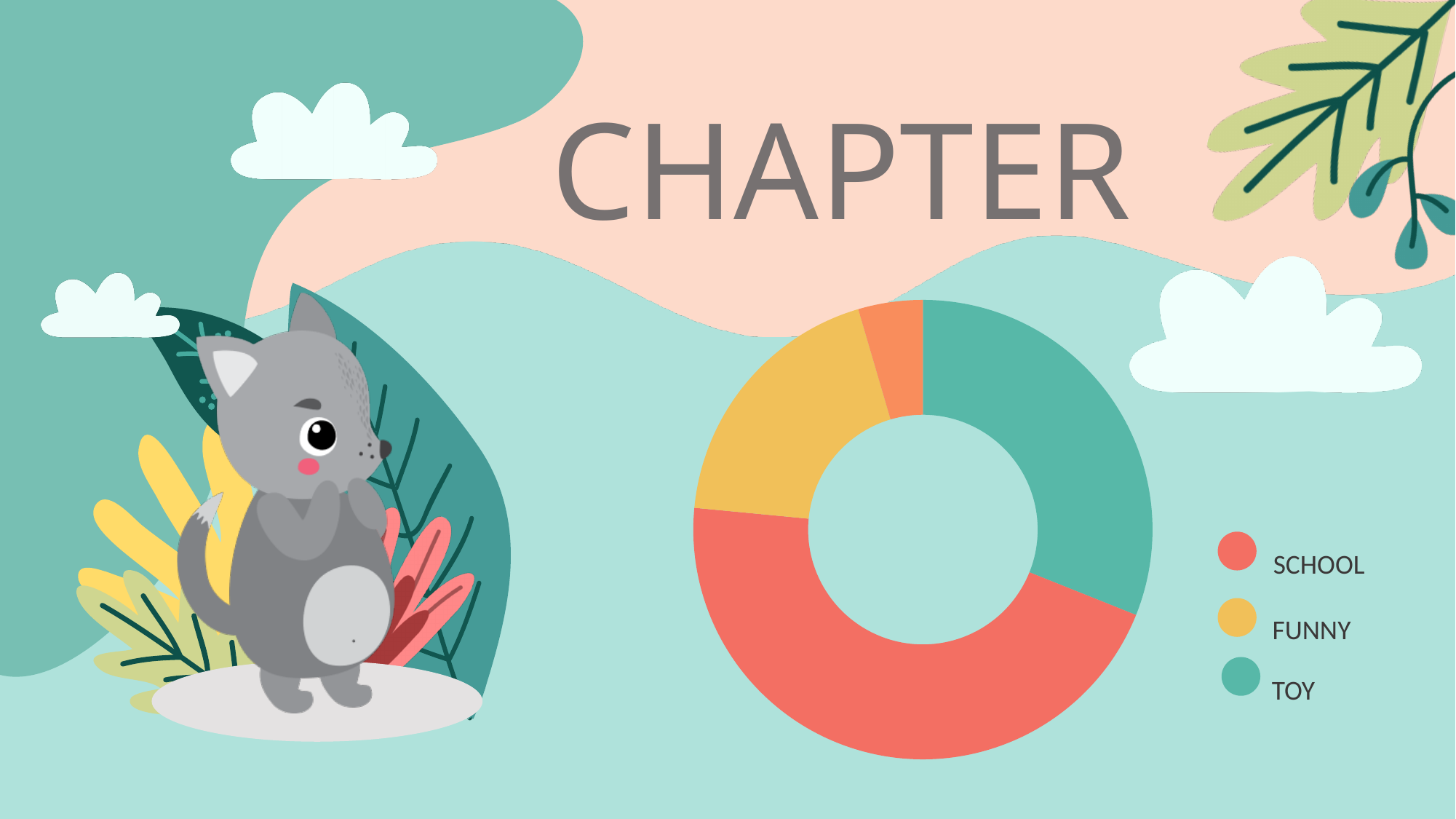
Which is larger in the doughnut chart, SCHOOL or FUNNY? SCHOOL Which category is shown in teal in the doughnut chart? TOY Which colour represents SCHOOL in the doughnut chart? Red How many entries does the chart's legend list? 3 Which is larger in the doughnut chart, SCHOOL or TOY? SCHOOL What kind of chart is shown on the slide? Doughnut (pie) chart Which category has the largest slice in the doughnut chart? SCHOOL Which is larger in the doughnut chart, TOY or FUNNY? TOY How many slices does the doughnut chart have? 4